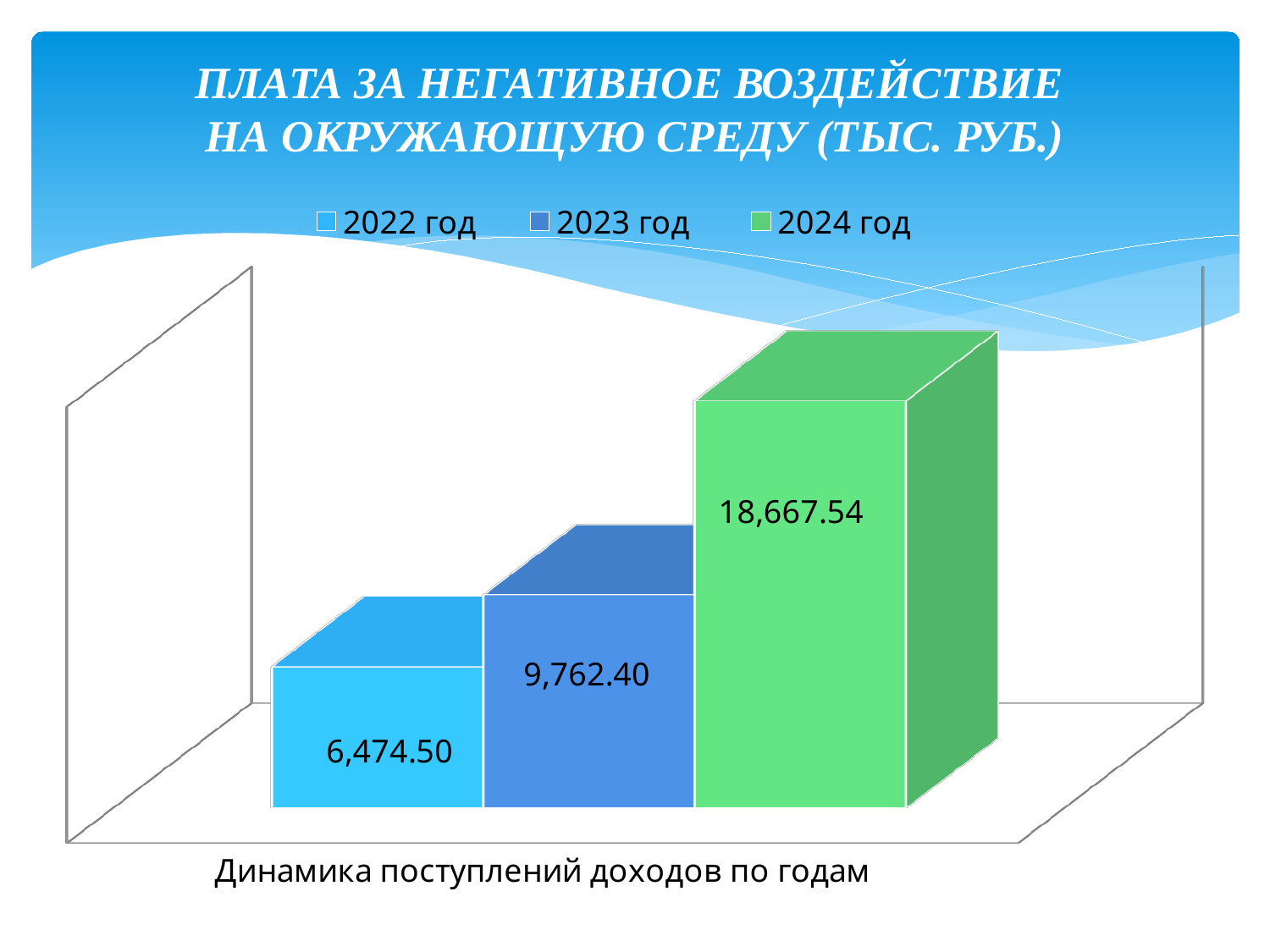
What is the value for 2024 год? 18,667.54 What is the value for 2023 год? 9,762.40 Do the values rise or fall from 2022 год to 2024 год? Rise What kind of chart is shown on the slide? Bar chart What is the difference between the values for 2024 год and 2023 год? 8,905.14 How many series does the legend list? 3 What is the difference between the values for 2023 год and 2022 год? 3,287.90 What is the title of the chart? ПЛАТА ЗА НЕГАТИВНОЕ ВОЗДЕЙСТВИЕ НА ОКРУЖАЮЩУЮ СРЕДУ (ТЫС. РУБ.) What is the value for 2022 год? 6,474.50 Which year has the lowest value? 2022 год Which year has the highest value? 2024 год Which is larger, the value for 2022 год or the value for 2023 год? 2023 год